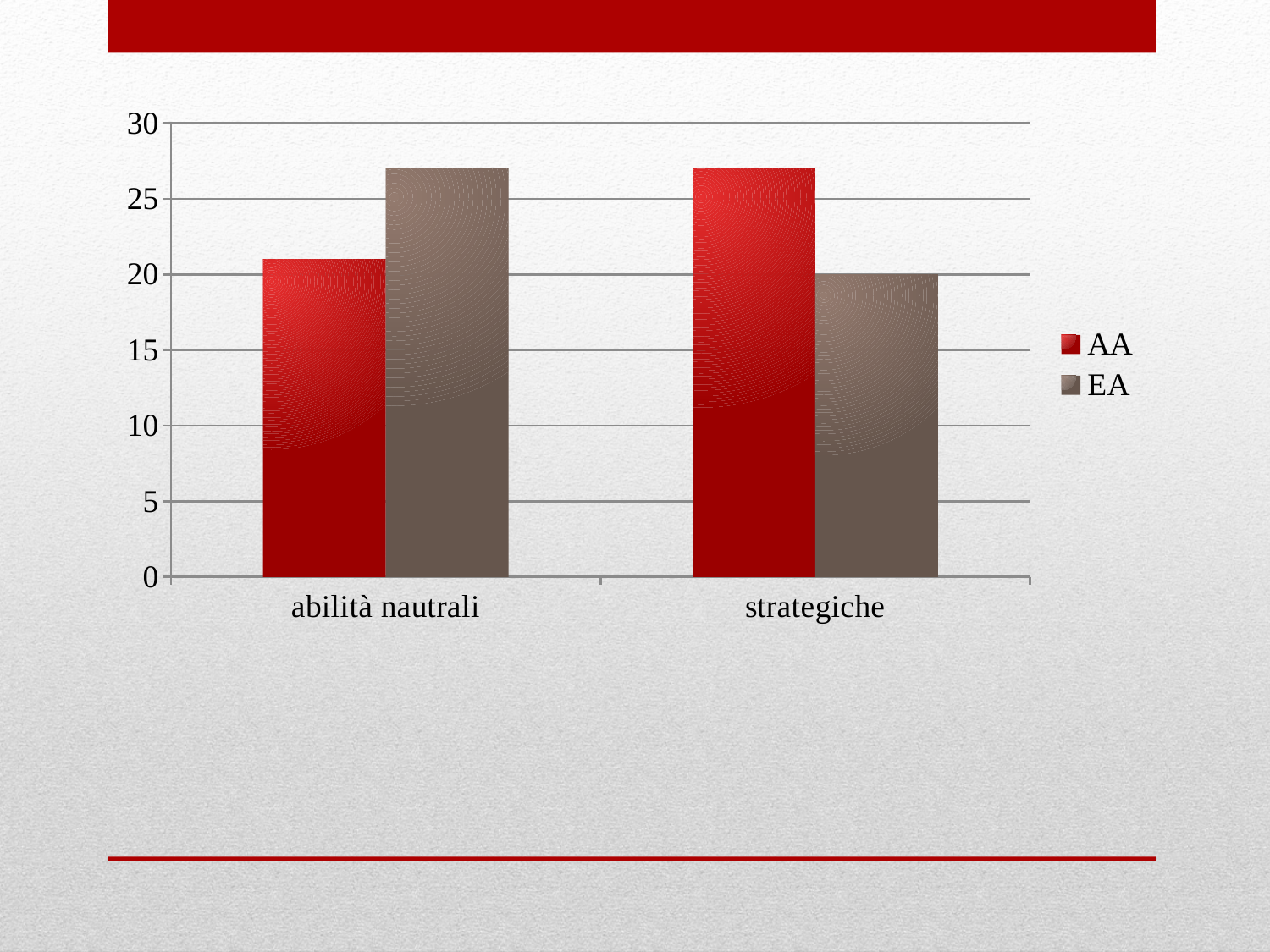
How many series does the legend list? 2 Is the value of AA for abilità nautrali greater or less than 20? greater For abilità nautrali, which series has the larger value, AA or EA? EA What kind of chart is shown on the slide? bar chart How many categories are shown on the x axis? 2 Which category has the lowest EA value? strategiche For strategiche, which series has the larger value, AA or EA? AA What is the value of EA for strategiche? 20 Is the value of AA for strategiche greater or less than 25? greater Which series is shown in red? AA Is the value of EA for abilità nautrali greater or less than 25? greater